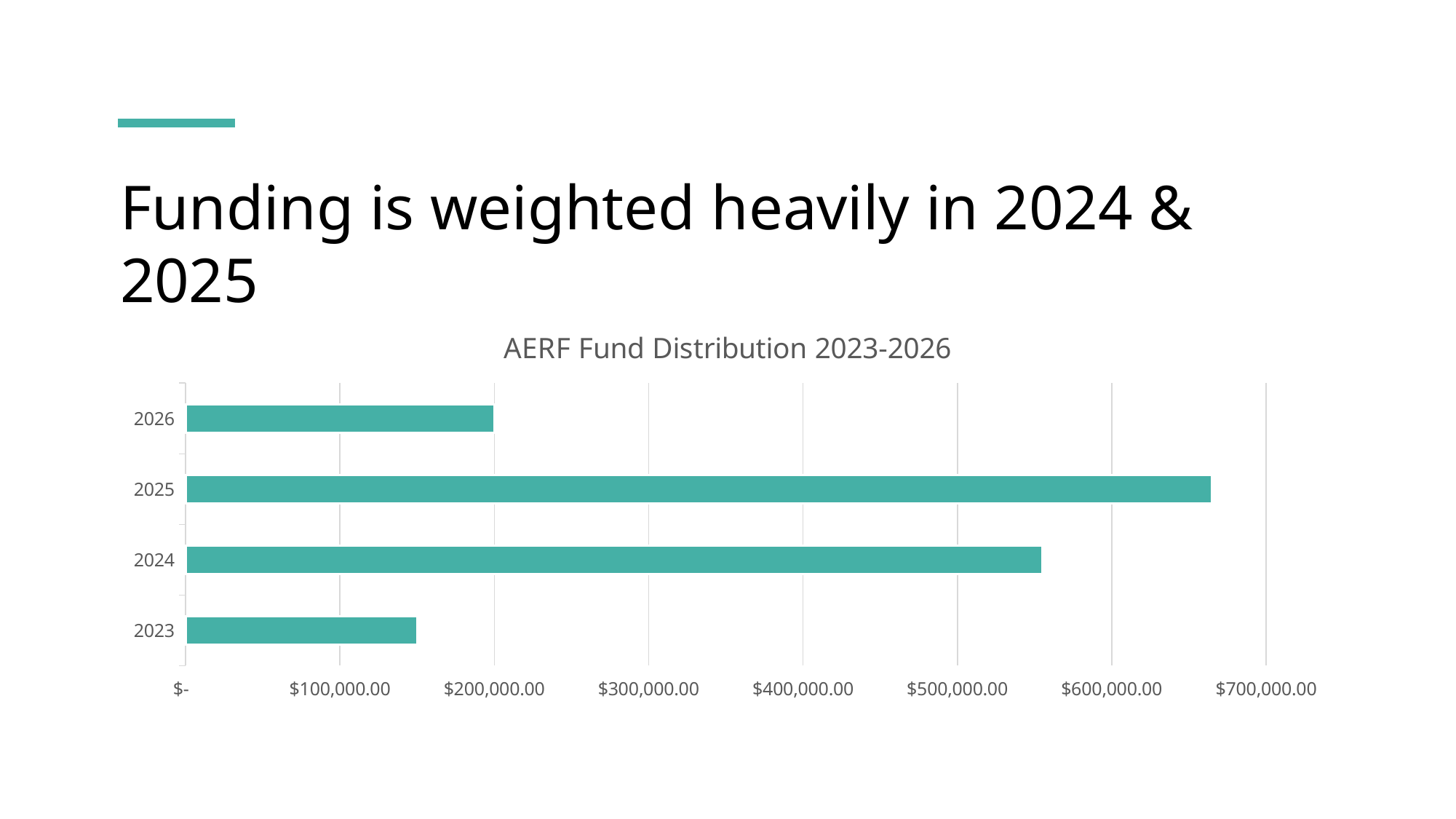
What is the funding value for 2026? $200,000.00 Is the value for 2024 greater or less than $600,000.00? less Is the value for 2024 greater or less than $500,000.00? greater Which year has more funding, 2024 or 2025? 2025 What is the title of the chart? AERF Fund Distribution 2023-2026 Which year has more funding, 2023 or 2026? 2026 Is the value for 2023 greater or less than $200,000.00? less What type of chart is shown on the slide? bar chart Which year has the highest funding? 2025 Which year has the lowest funding? 2023 How many years are shown in the chart? 4